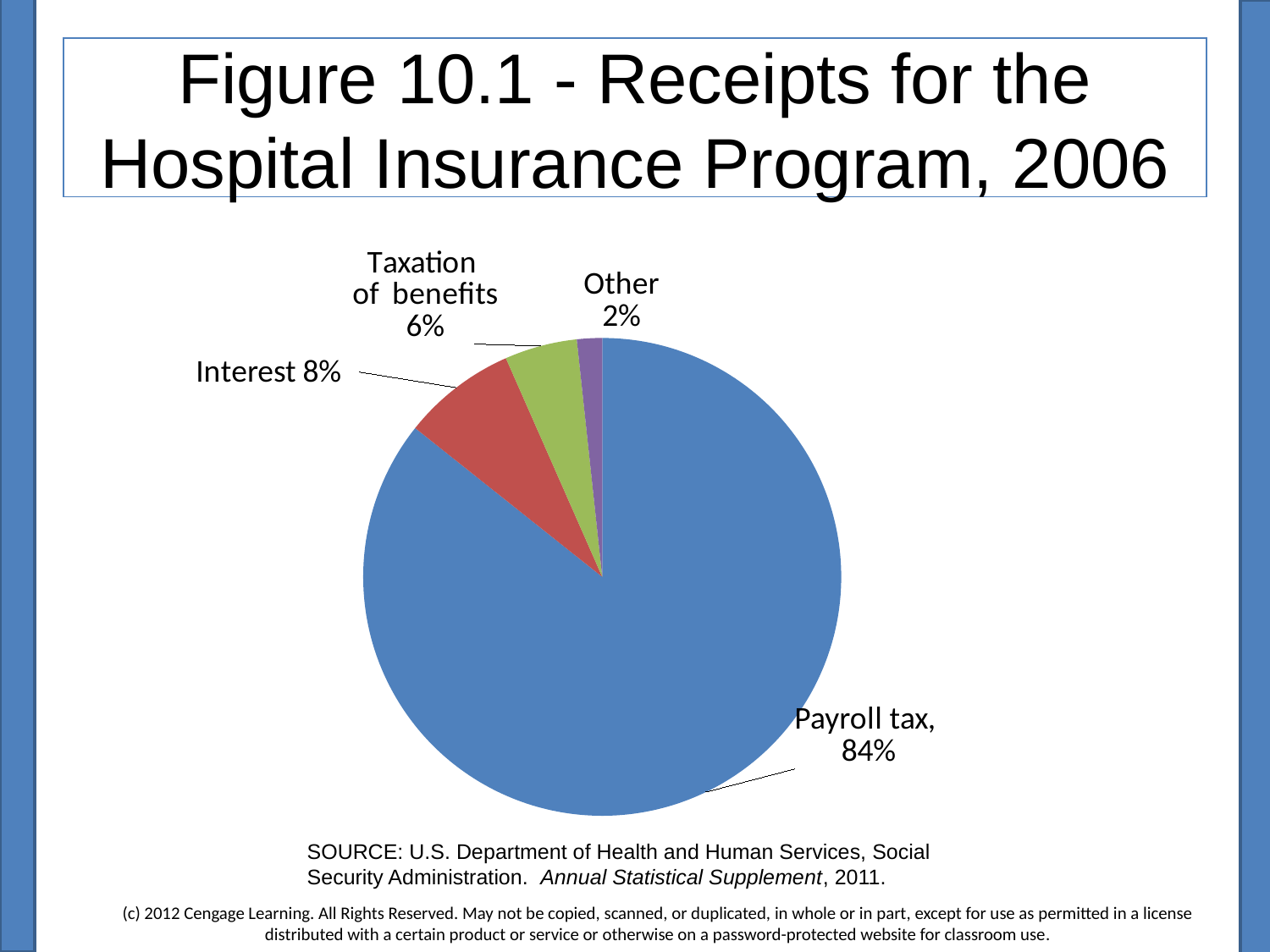
What share of receipts comes from interest? 8% What kind of chart is shown on the slide? pie chart Which source accounts for the smallest share of receipts? Other Which source accounts for the largest share of receipts? Payroll tax What is the difference in percentage points between the interest share and the taxation of benefits share? 2 What is the title of the figure on the slide? Figure 10.1 - Receipts for the Hospital Insurance Program, 2006 What is the difference in percentage points between the payroll tax share and the interest share? 76 How many slices does the pie chart have? 4 Which is larger, the share from interest or the share from taxation of benefits? Interest What share of receipts is labelled Other? 2% What share of receipts comes from payroll tax? 84%